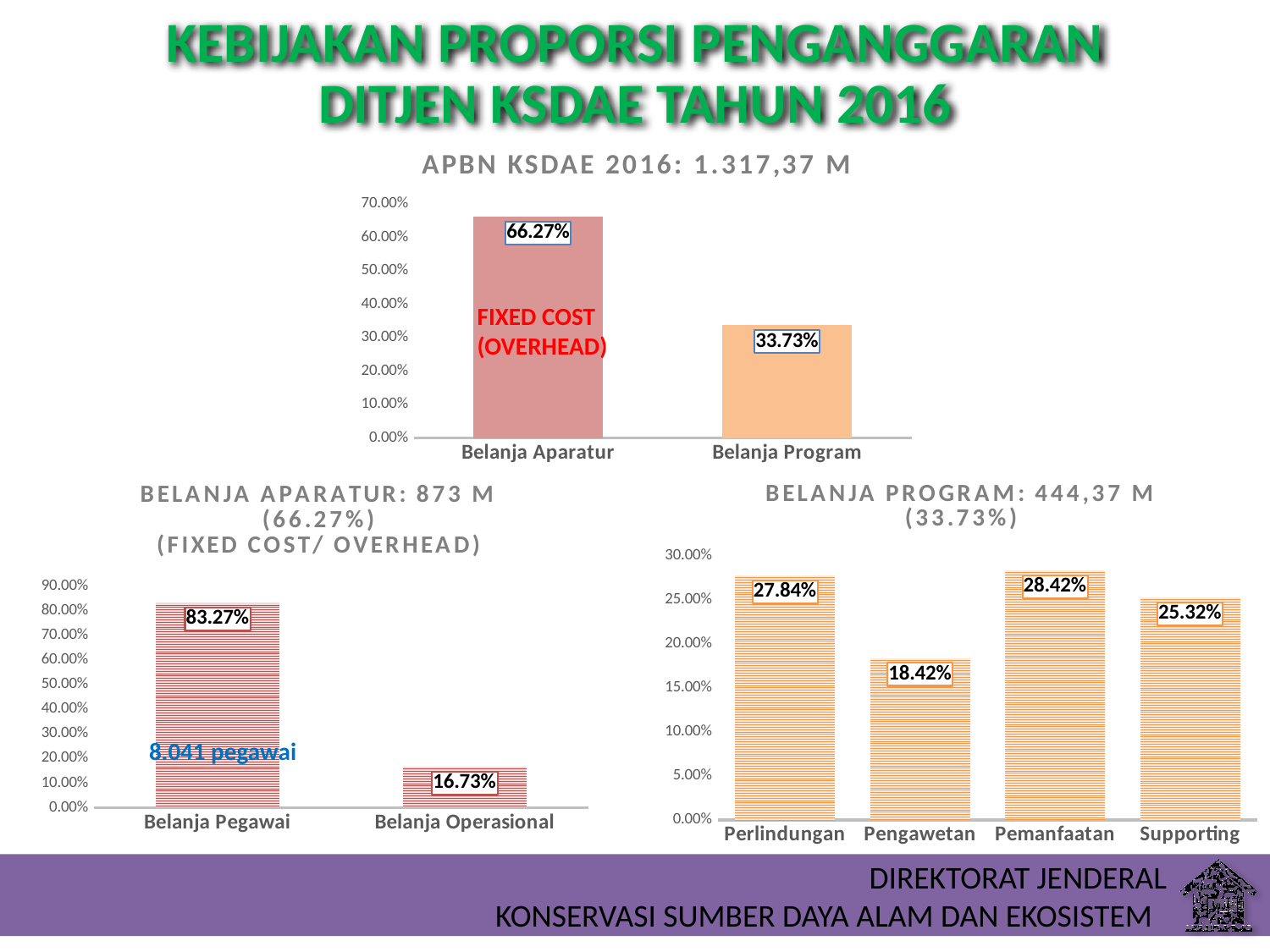
In the bottom-left chart titled 'BELANJA APARATUR: 873 M', what is the value for Belanja Operasional? 16.73% In the bottom-left chart titled 'BELANJA APARATUR: 873 M', what is the value for Belanja Pegawai? 83.27% In the bottom-right chart titled 'BELANJA PROGRAM: 444,37 M', how many categories are shown? 4 In the top chart titled 'APBN KSDAE 2016: 1.317,37 M', what is the difference between Belanja Aparatur and Belanja Program? 32.54% In the bottom-right chart titled 'BELANJA PROGRAM: 444,37 M', which category has the lowest value? Pengawetan In the bottom-right chart titled 'BELANJA PROGRAM: 444,37 M', which category has the highest value? Pemanfaatan In the bottom-right chart titled 'BELANJA PROGRAM: 444,37 M', what is the difference between Perlindungan and Supporting? 2.52% In the top chart titled 'APBN KSDAE 2016: 1.317,37 M', what is the value for Belanja Program? 33.73% What type of chart is the top chart titled 'APBN KSDAE 2016: 1.317,37 M'? Bar chart In the bottom-right chart titled 'BELANJA PROGRAM: 444,37 M', what is the value for Pengawetan? 18.42% In the bottom-left chart titled 'BELANJA APARATUR: 873 M', which category has the higher value? Belanja Pegawai In the top chart titled 'APBN KSDAE 2016: 1.317,37 M', what is the value for Belanja Aparatur? 66.27%